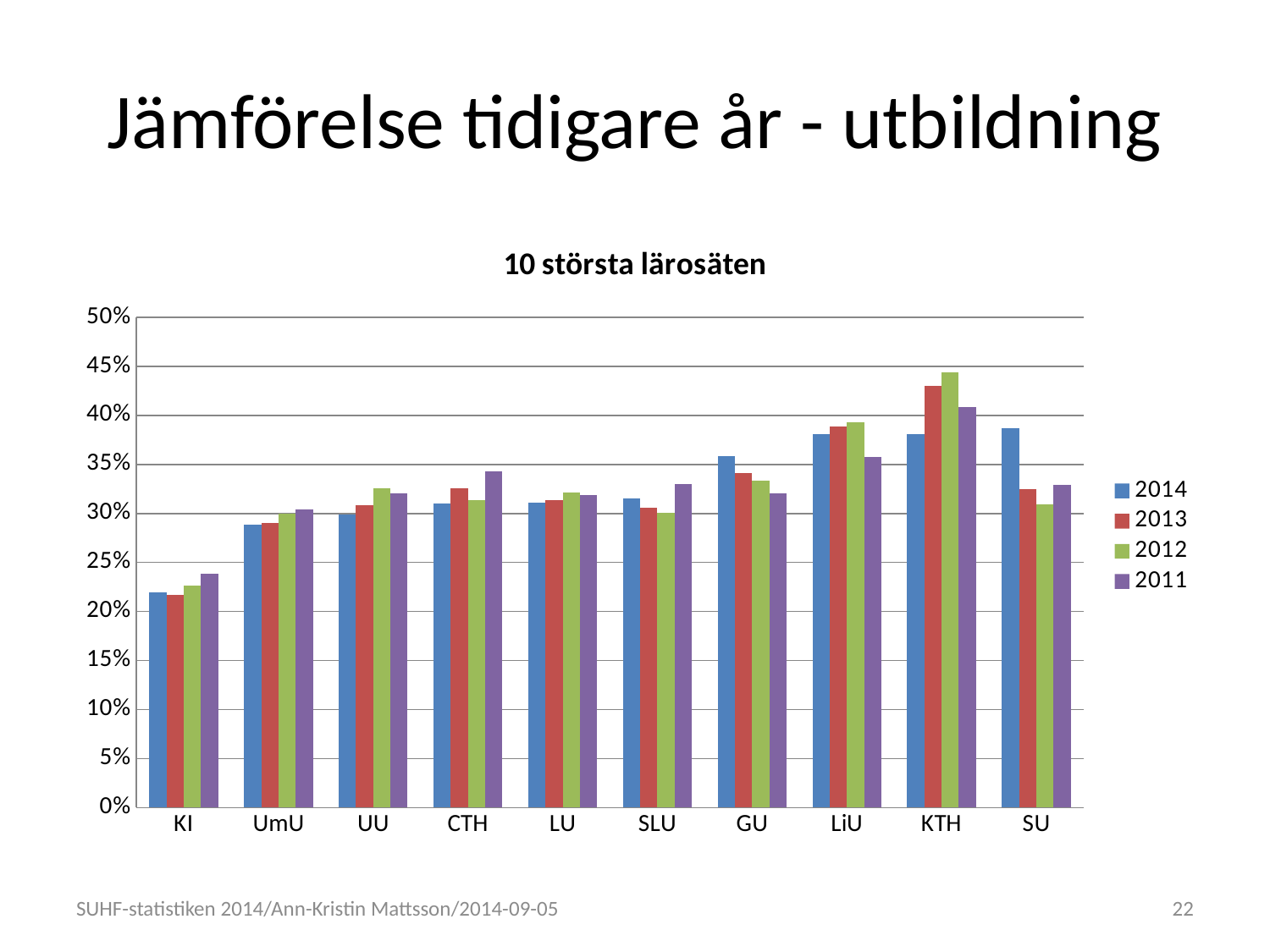
How many series does the legend of the chart list? 4 What kind of chart is shown on the slide? Bar chart How many institutions (categories) are shown on the x axis of the chart? 10 For CTH, which is larger: the 2011 value or the 2014 value? 2011 Is the 2014 value for SU greater or less than 35%? greater Is the 2014 value for KI greater or less than 25%? less Is the 2012 value for KTH greater or less than 40%? greater Which institution has the lowest values in the chart? KI Which institution has the highest bar in the chart? KTH What is the title of the chart? 10 största lärosäten For SU, which is larger: the 2014 value or the 2013 value? 2014